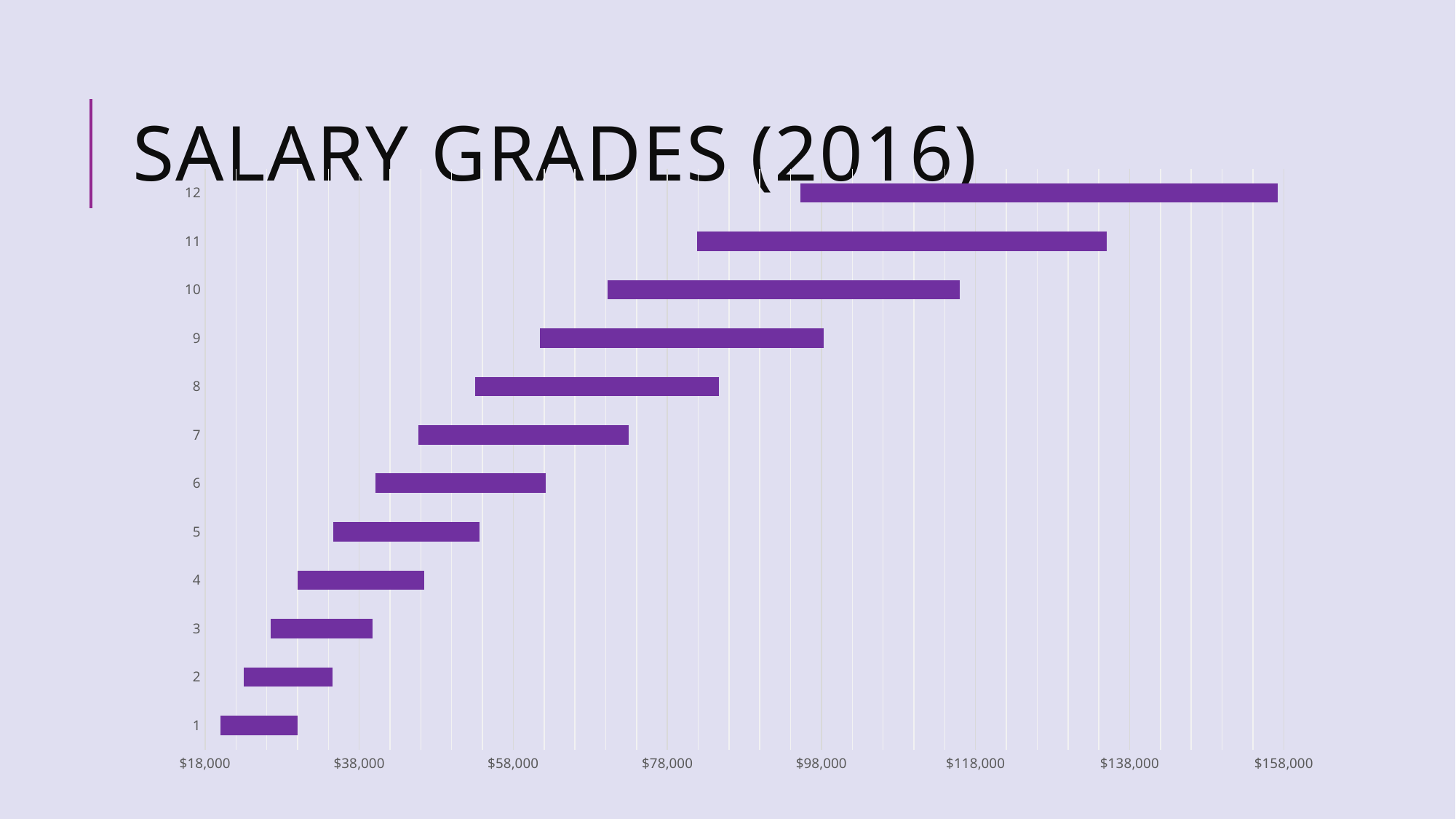
What kind of chart is shown on the slide? bar chart Which grade has the wider salary range, grade 12 or grade 1? 12 Is the upper end of the salary range for grade 1 greater or less than $38,000? less What is the title of the chart? SALARY GRADES (2016) How many salary grades are plotted on the chart? 12 Is the lower end of the salary range for grade 11 greater or less than $78,000? greater Which salary grade reaches the highest salary on the chart? 12 Which salary grade has the lowest salary range on the chart? 1 Is the upper end of the salary range for grade 8 greater or less than $78,000? greater Do the salary ranges rise or fall as the grade number increases from 1 to 12? rise